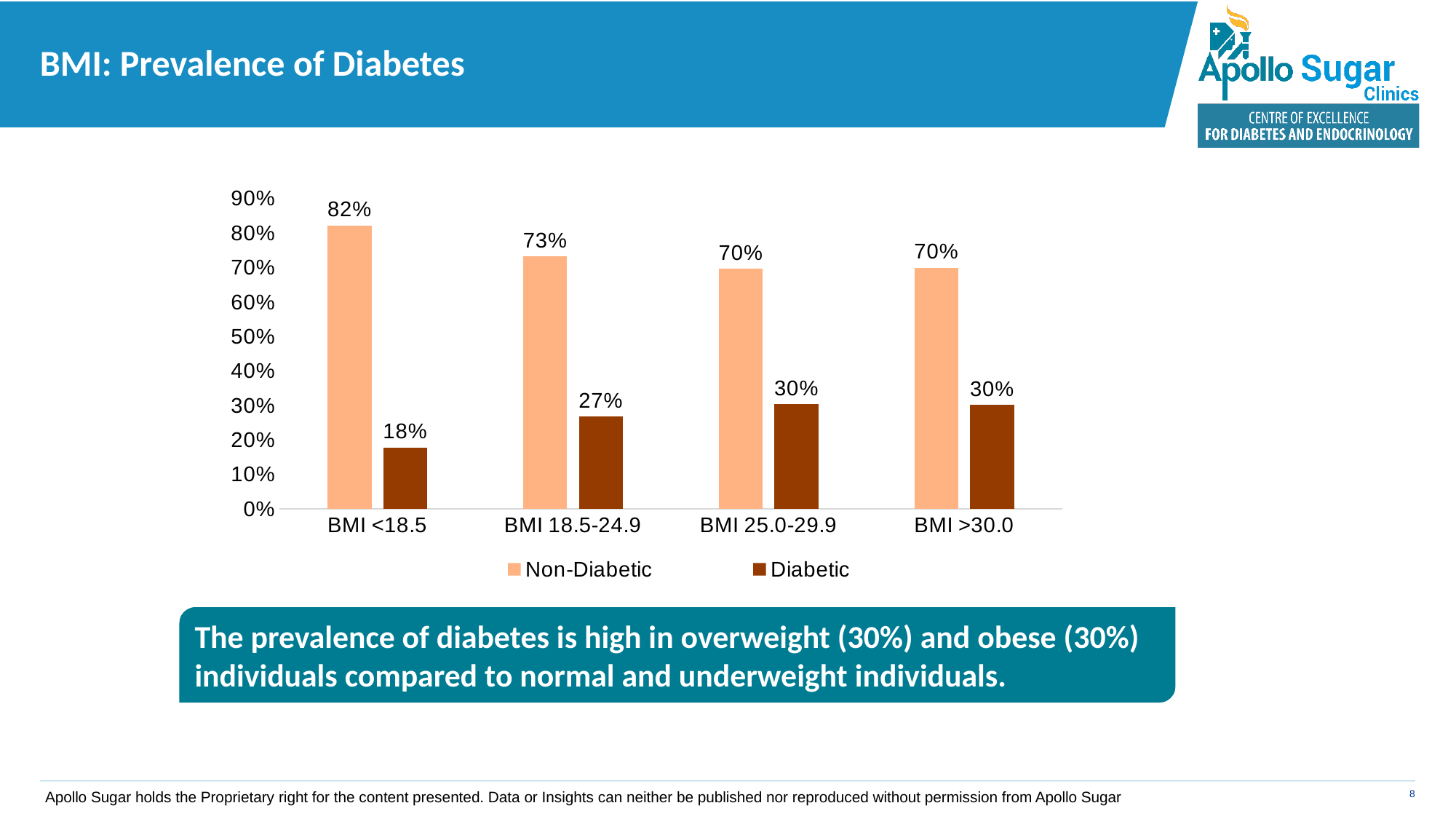
Which is larger, the Diabetic value for BMI 18.5-24.9 or for BMI 25.0-29.9? BMI 25.0-29.9 How many series does the legend list? 2 Which BMI category has the highest Non-Diabetic value? BMI <18.5 What is the Diabetic value for BMI 25.0-29.9? 30% Which BMI category has the lowest Diabetic value? BMI <18.5 Which series is shown in dark brown in the legend? Diabetic What is the Diabetic value for BMI <18.5? 18% What is the difference between the Non-Diabetic and Diabetic values for BMI 18.5-24.9? 46% What is the difference between the Diabetic values for BMI >30.0 and BMI <18.5? 12% What is the Non-Diabetic value for BMI 18.5-24.9? 73% How many BMI categories are shown on the x axis? 4 What kind of chart is shown on the slide? Bar chart